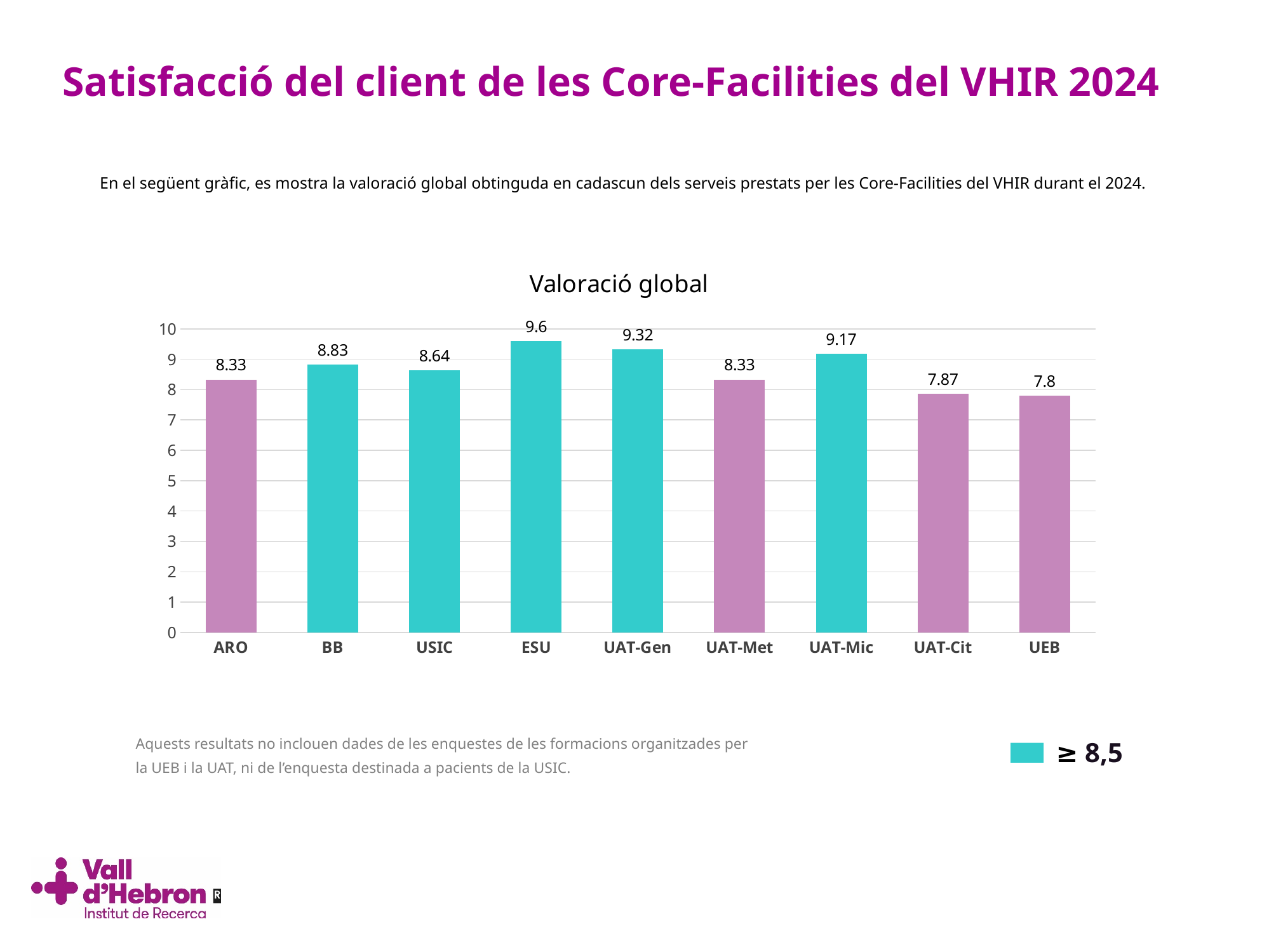
What is the value for UAT-Cit? 7.87 Which is larger, the value for USIC or the value for UAT-Met? USIC What is the title of the chart? Valoració global Is the value for UAT-Cit greater or less than 8? less Which category has the lowest value? UEB What is the difference between the values for UAT-Gen and UAT-Mic? 0.15 What is the value for ESU? 9.6 What is the value for BB? 8.83 How many categories are shown on the x axis? 9 What kind of chart is shown? bar chart Which category has the highest value? ESU What is the difference between the values for ESU and UEB? 1.8